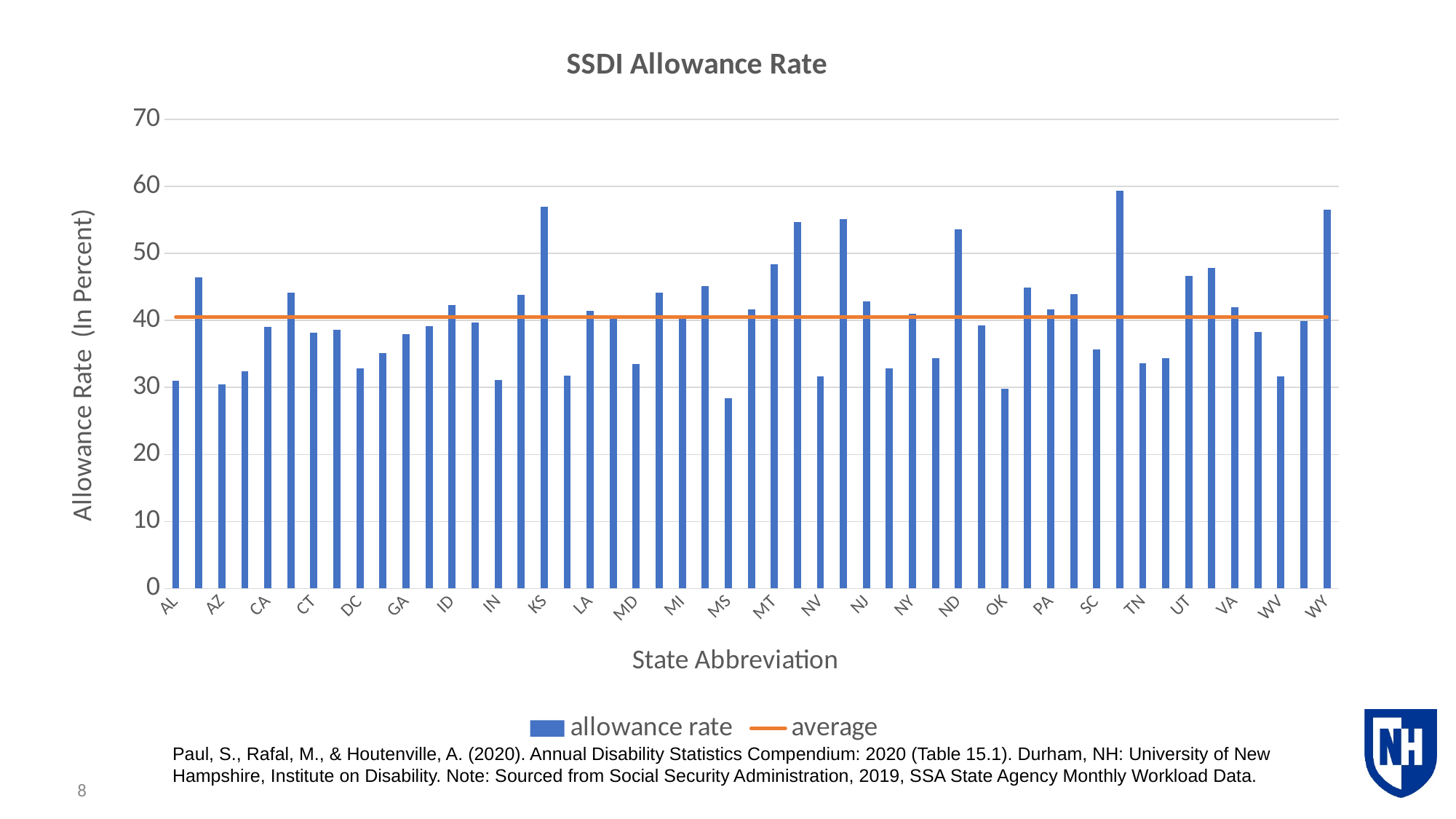
Is the allowance rate for WY greater or less than 50? greater Is the allowance rate for AL greater or less than 40? less What kind of chart is shown on the slide? combination bar and line chart Is the allowance rate for KS greater or less than 50? greater Which has the larger allowance rate, KS or AL? KS Which has the larger allowance rate, MS or WY? WY What is the title of the chart? SSDI Allowance Rate How many series does the legend list? 2 What is the label of the x axis? State Abbreviation